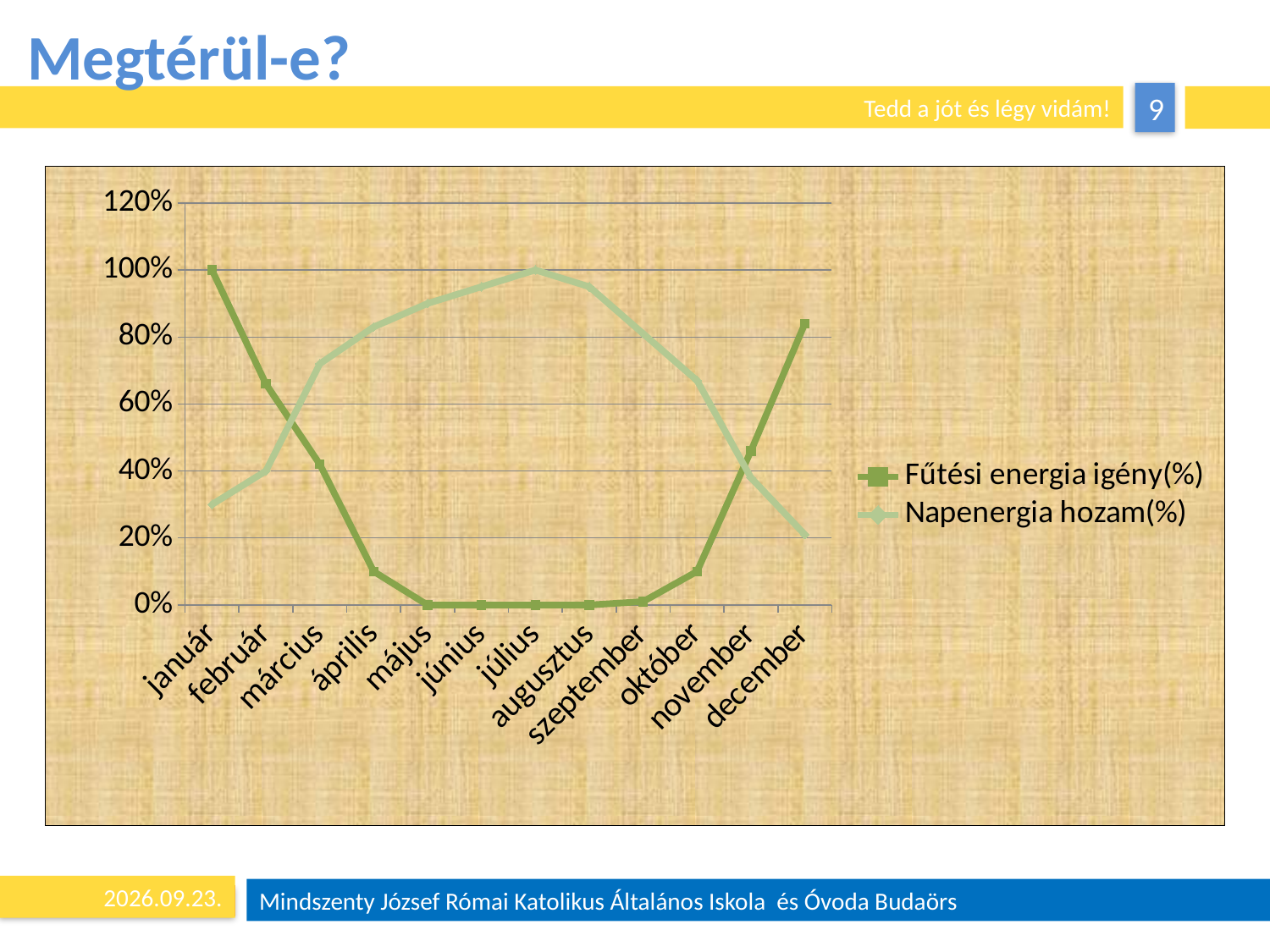
How many series does the legend list? 2 Which month has the highest Fűtési energia igény(%)? január What kind of chart is shown on the slide? line chart What is the value of Napenergia hozam(%) for július? 100% Is the value of Fűtési energia igény(%) for december greater or less than 80%? greater What is the value of Fűtési energia igény(%) for június? 0% What is the value of Fűtési energia igény(%) for január? 100% Does Fűtési energia igény(%) rise or fall from január to április? fall In március, which series has the larger value, Fűtési energia igény(%) or Napenergia hozam(%)? Napenergia hozam(%) Which month has the highest Napenergia hozam(%)? július Is the value of Napenergia hozam(%) for január greater or less than 40%? less How many months are shown on the x axis? 12